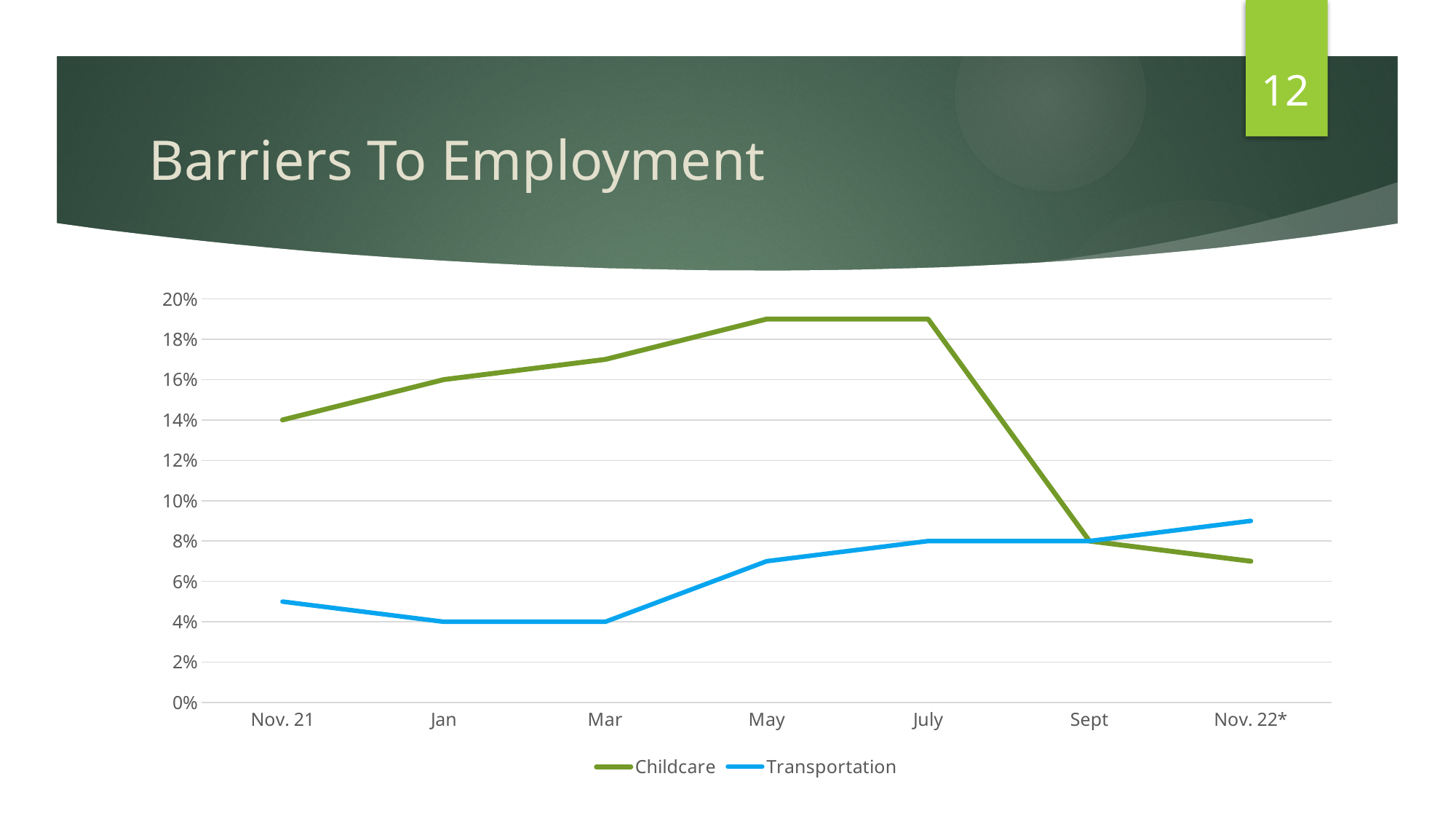
What kind of chart is shown on the slide? line chart Is the Childcare value for May greater or less than 18%? greater What is the Childcare value for Jan? 16% What is the Transportation value for Sept? 8% Does the Childcare line rise or fall from Nov. 21 to May? rise Which series has the larger value at Nov. 22*, Childcare or Transportation? Transportation Is the Transportation value for Nov. 22* greater or less than 8%? greater What is the Childcare value for Nov. 21? 14% What is the difference between the Childcare and Transportation values in Jan? 12 percentage points What is the Transportation value for Mar? 4% How many series does the legend list? 2 How many points are plotted along the x axis for each series? 7